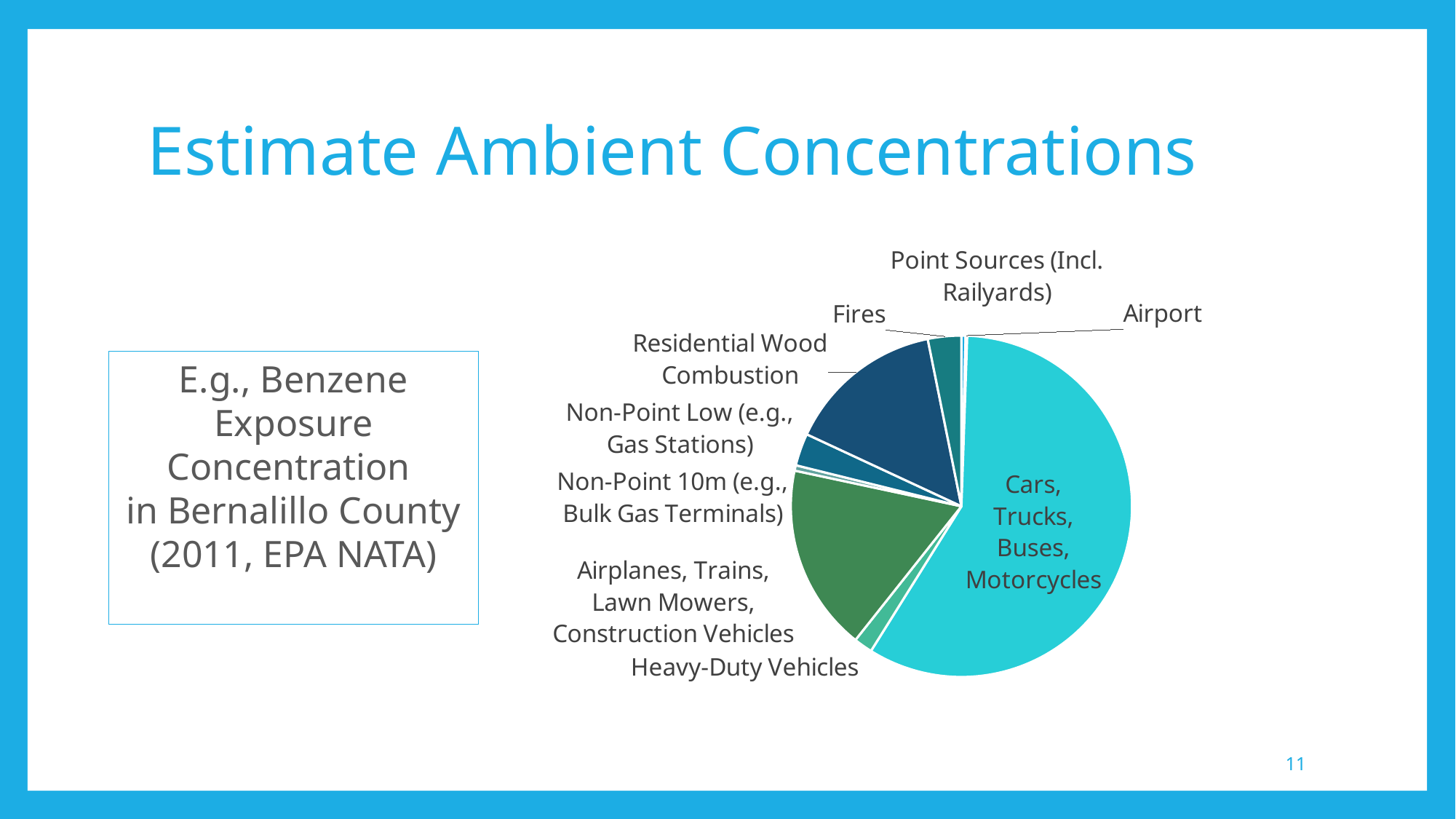
Which slice is larger: Residential Wood Combustion or Fires? Residential Wood Combustion Which slice is larger: Fires or Airport? Fires Which slice is larger: Airplanes, Trains, Lawn Mowers, Construction Vehicles or Heavy-Duty Vehicles? Airplanes, Trains, Lawn Mowers, Construction Vehicles Which pollutant's exposure concentration does the pie chart illustrate, according to the text box? Benzene How many categories (slices) does the pie chart have? 9 Which category has the largest slice of the pie chart? Cars, Trucks, Buses, Motorcycles What kind of chart is shown on the slide? pie chart Which county and year does the pie chart's data refer to, according to the text box? Bernalillo County, 2011